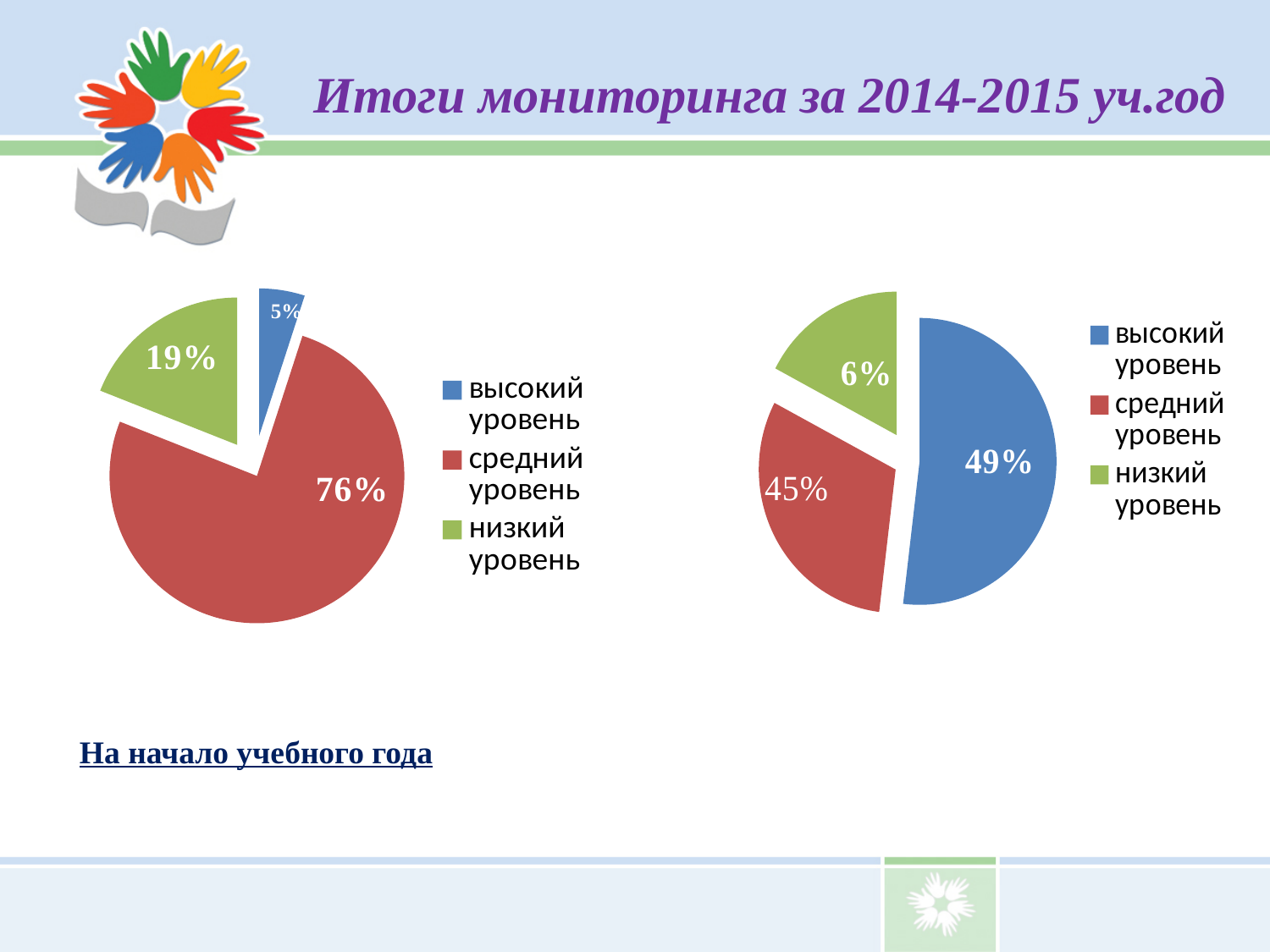
In the right pie chart, what share is labelled for средний уровень? 45% In the right pie chart, which category has the smallest slice? низкий уровень In the right pie chart, what share is labelled for высокий уровень? 49% In the right pie chart, what share is labelled for низкий уровень? 6% In the left pie chart, what is the difference between the shares for средний уровень and низкий уровень? 57% What type of chart is shown on the right side of the slide? pie chart In the left pie chart, what share is labelled for высокий уровень? 5% In the left pie chart, what share is labelled for низкий уровень? 19% In the right pie chart, which is larger: the share for высокий уровень or the share for низкий уровень? высокий уровень How many slices does the left pie chart have? 3 In the left pie chart, what share is labelled for средний уровень? 76% In the left pie chart, which category has the largest slice? средний уровень